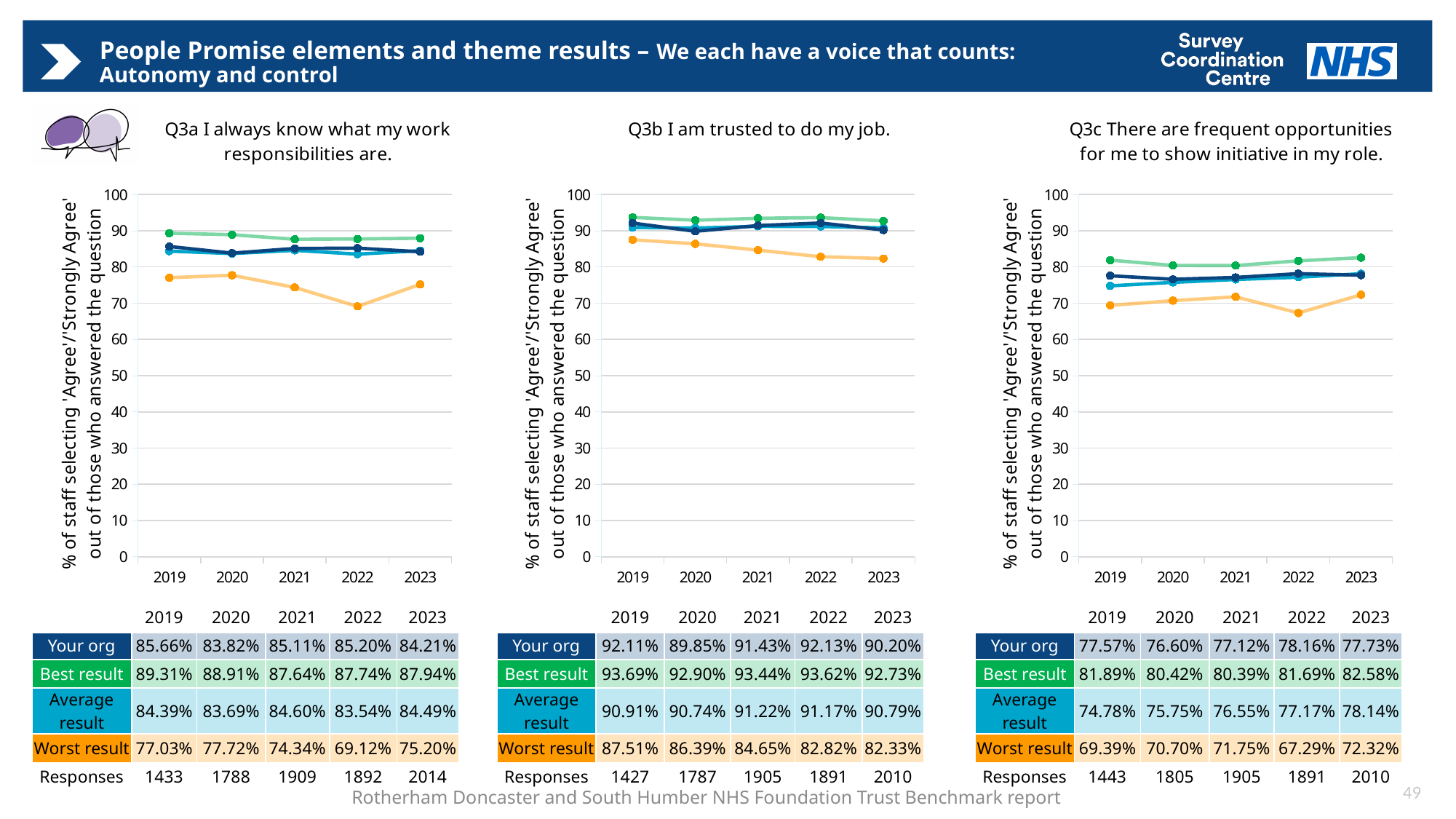
In the Q3b chart, does the Worst result series rise or fall from 2019 to 2023? Fall In the Q3c chart, in which year is the Best result series at its highest? 2023 In the Q3a chart (I always know what my work responsibilities are), what is the Your org value for 2023? 84.21% In the Q3a chart, what is the difference between the Best result and Your org values in 2019? 3.65 percentage points What kind of chart is used for Q3b? Line chart In the Q3c chart (There are frequent opportunities for me to show initiative in my role), what is the Best result value for 2023? 82.58% In the Q3b chart (I am trusted to do my job), what is the Worst result value for 2022? 82.82% How many series are plotted in the Q3a chart? 4 In the Q3a chart, in which year is the Worst result series at its lowest? 2022 In the Q3b chart, which is larger in 2020: Your org or Average result? Average result In the Q3c chart, is the Worst result value for 2022 greater or less than 70? less How many years are plotted on the x axis of the Q3c chart? 5